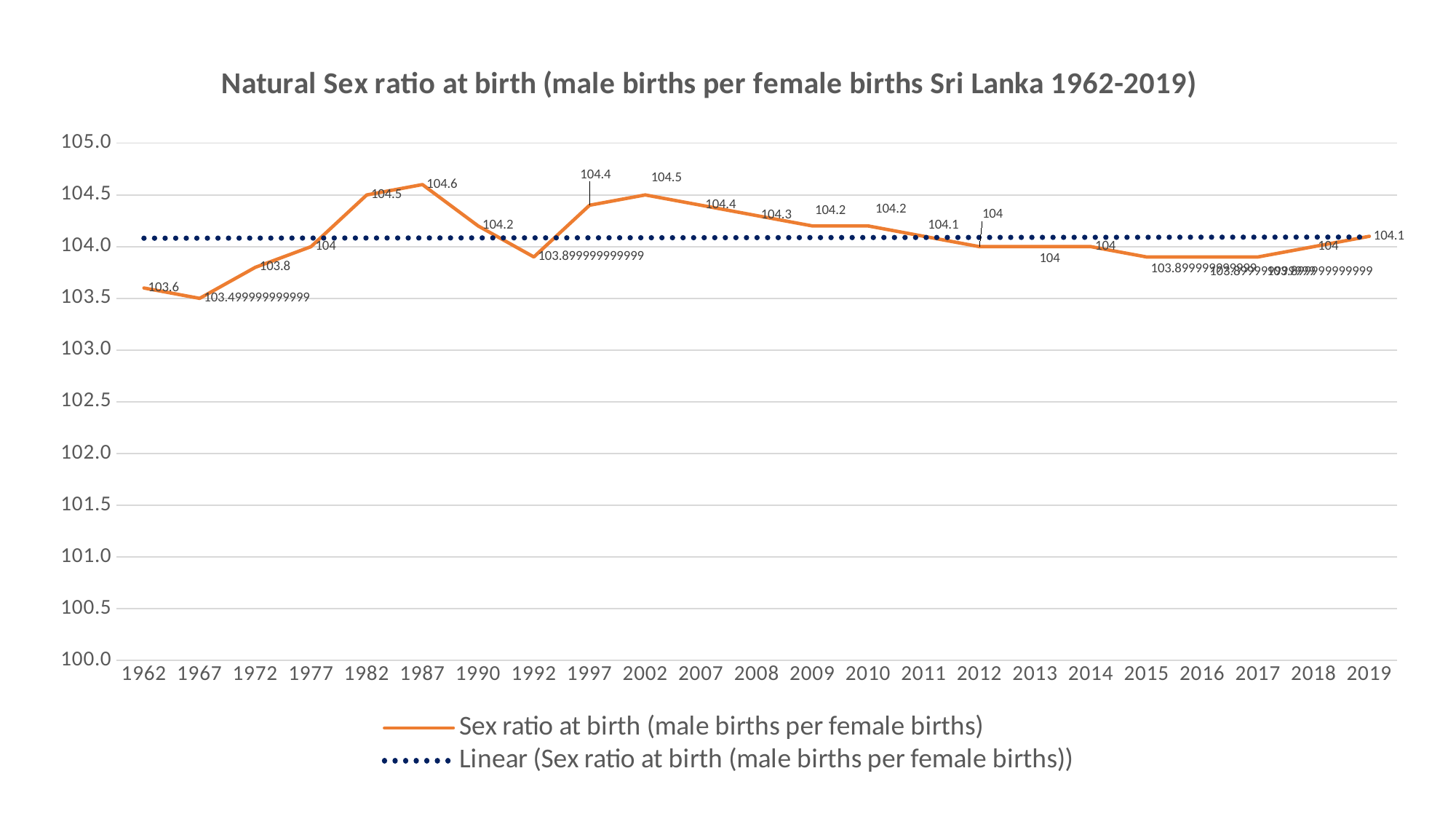
How many years are plotted on the x axis? 23 What is the difference between the sex ratio at birth in 1987 and in 1962? 1.0 What is the sex ratio at birth value for 1987? 104.6 Which year has a higher sex ratio at birth, 1982 or 1990? 1982 Which year has the highest sex ratio at birth? 1987 What is the sex ratio at birth value for 2002? 104.5 How many series does the legend list? 2 Is the sex ratio at birth for 1967 greater or less than 104.0? less What is the sex ratio at birth value for 2019? 104.1 Which year has the lowest sex ratio at birth? 1967 What is the sex ratio at birth value for 1962? 103.6 What kind of chart is shown on the slide? Line chart